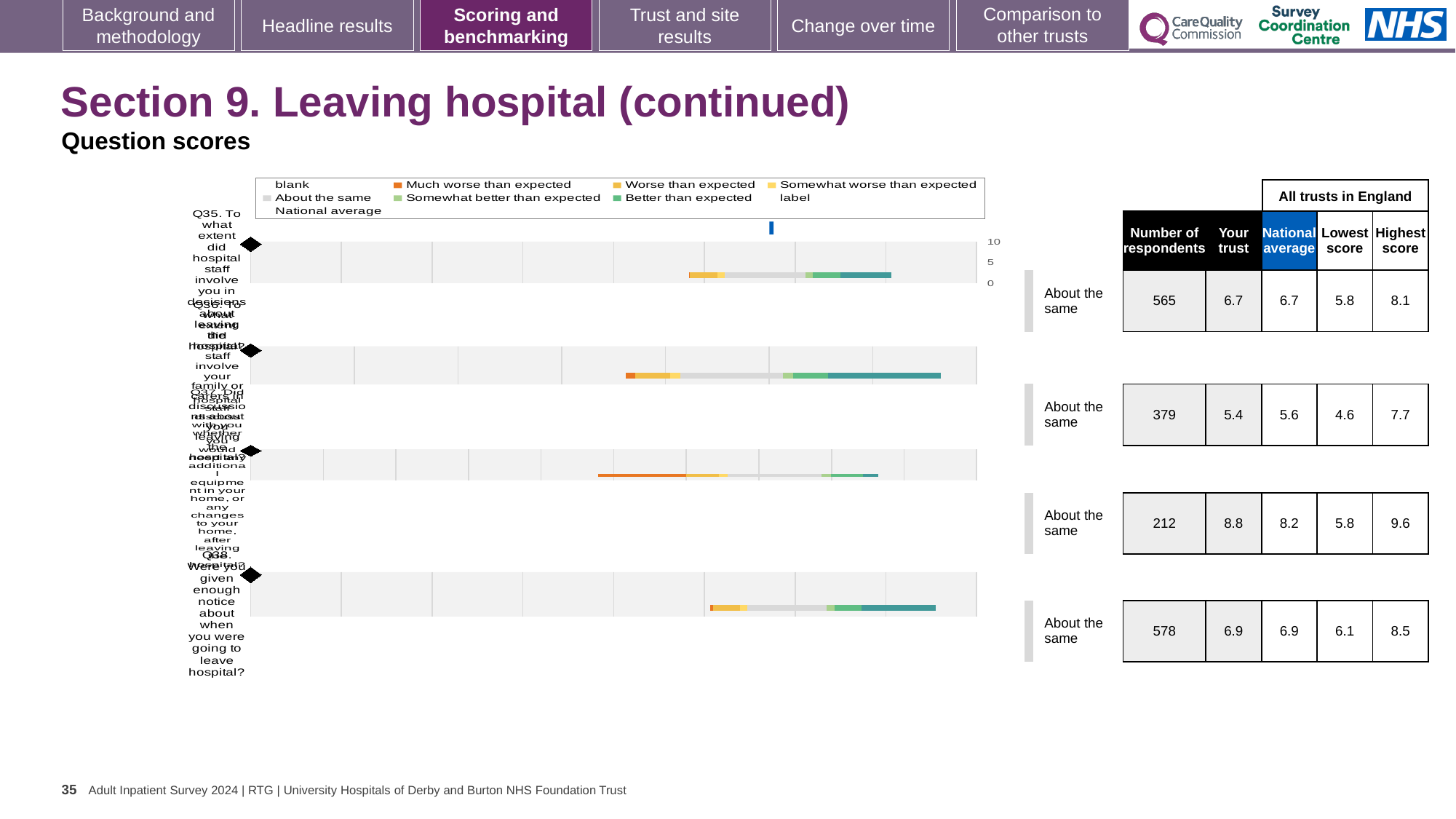
In the table beside the chart, what is the difference between the 'Your trust' score and the national average for Q37? 0.6 Which legend entry is shown in orange in the chart's legend? Much worse than expected Which legend entry is shown in light grey in the chart's legend? About the same In the table beside the chart, what is the benchmark category shown for Q38? About the same In the table beside the chart, is the 'Your trust' score for Q36 higher or lower than the national average? lower How many questions (categories) are plotted as bars in the chart? 4 In the table beside the chart, which question has the lowest 'Your trust' score? Q36 What kind of chart is shown on the slide? bar chart In the table beside the chart, what is the highest score for Q38? 8.5 In the table beside the chart, what is the 'Your trust' score for Q35? 6.7 In the table beside the chart, which question has the highest 'Your trust' score? Q37 In the table beside the chart, what is the number of respondents for Q37? 212